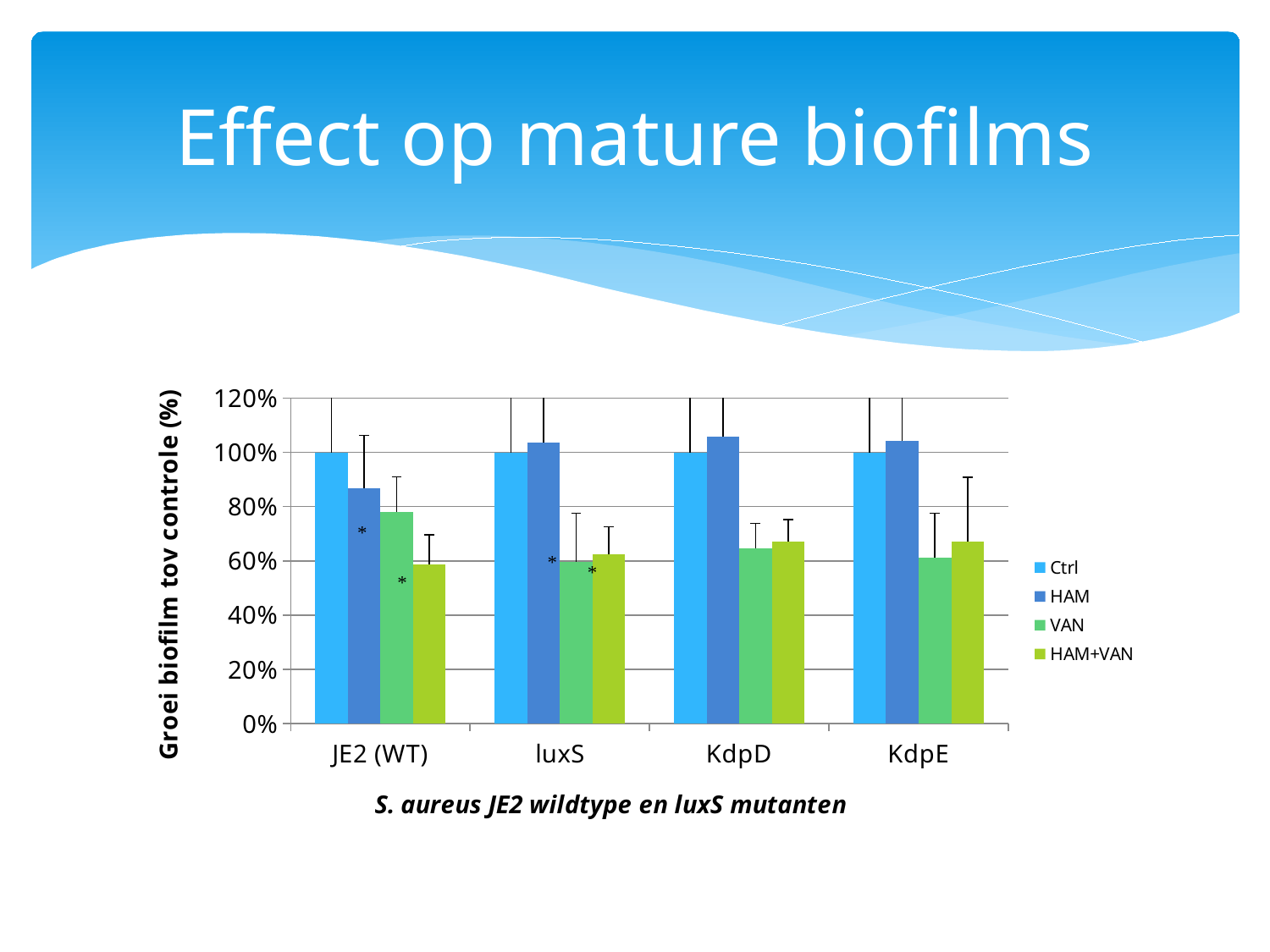
What is the value of the Ctrl bar for KdpE? 100% What is the value of the Ctrl bar for JE2 (WT)? 100% What kind of chart is shown on the slide? bar chart Is the value of the VAN bar for KdpD greater or less than 80%? less Is the value of the HAM bar for JE2 (WT) greater or less than 100%? less For JE2 (WT), which bar is larger: HAM or VAN? HAM How many categories are shown on the x axis of the chart? 4 How many series does the chart's legend list? 4 What is the title of the chart's y axis? Groei biofilm tov controle (%) Is the value of the HAM bar for KdpD greater or less than 100%? greater For JE2 (WT), which series has the lowest bar? HAM+VAN